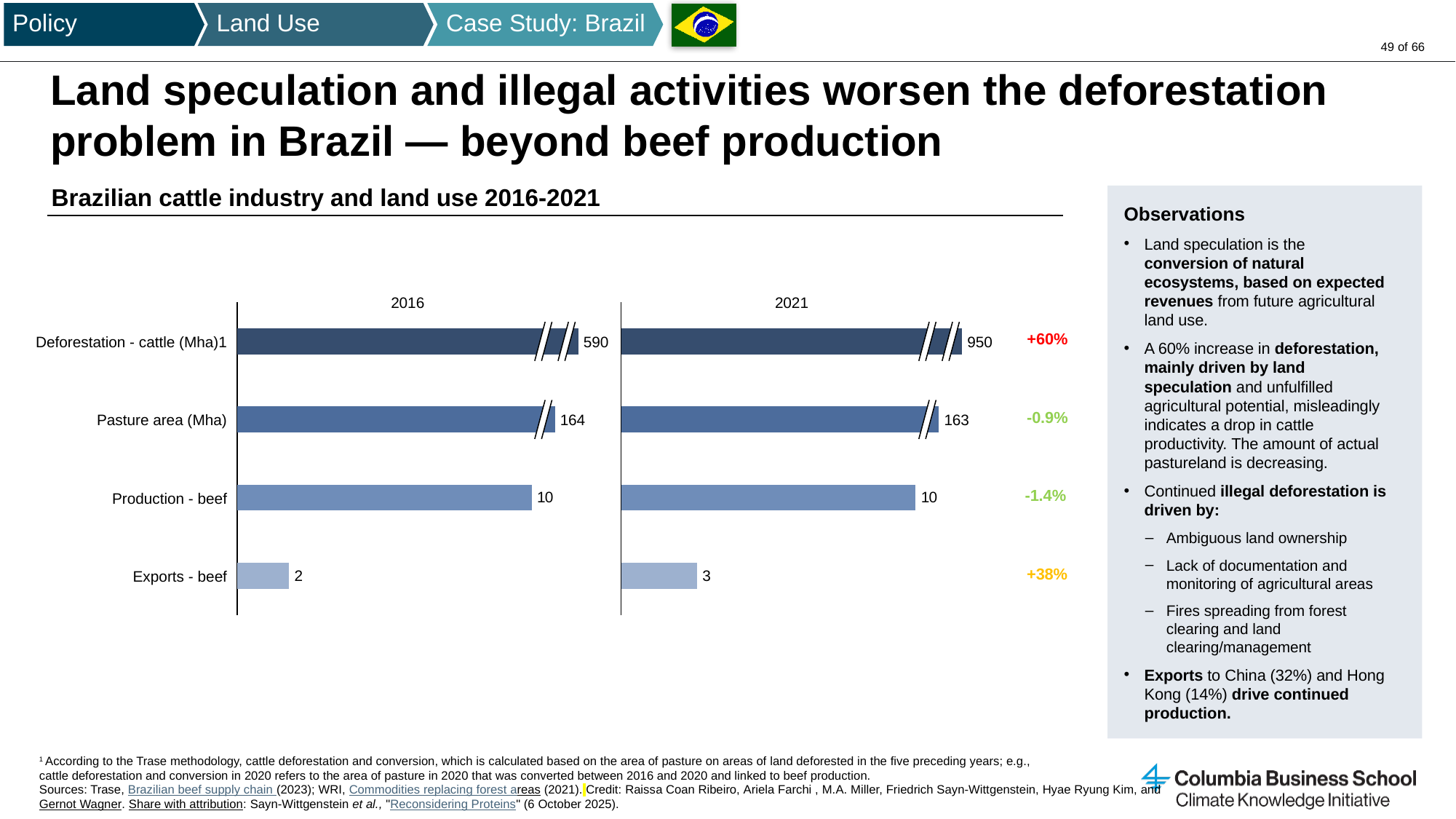
What type of chart is shown on the slide? Bar chart What is the Pasture area (Mha) value shown for 2021? 163 Which category has the lowest value in the 2016 panel? Exports - beef How many categories are plotted in the chart? 4 What is the value for Deforestation - cattle (Mha) in 2021? 950 What is the title of the chart? Brazilian cattle industry and land use 2016-2021 Which category has the highest value in the 2021 panel? Deforestation - cattle (Mha) By how much did the Deforestation - cattle value increase from 2016 to 2021? 360 What percentage change is shown next to the Exports - beef bars? +38% What is the value for Exports - beef in 2016? 2 Which year has the larger Pasture area (Mha) value, 2016 or 2021? 2016 What is the value for Deforestation - cattle (Mha) in 2016? 590